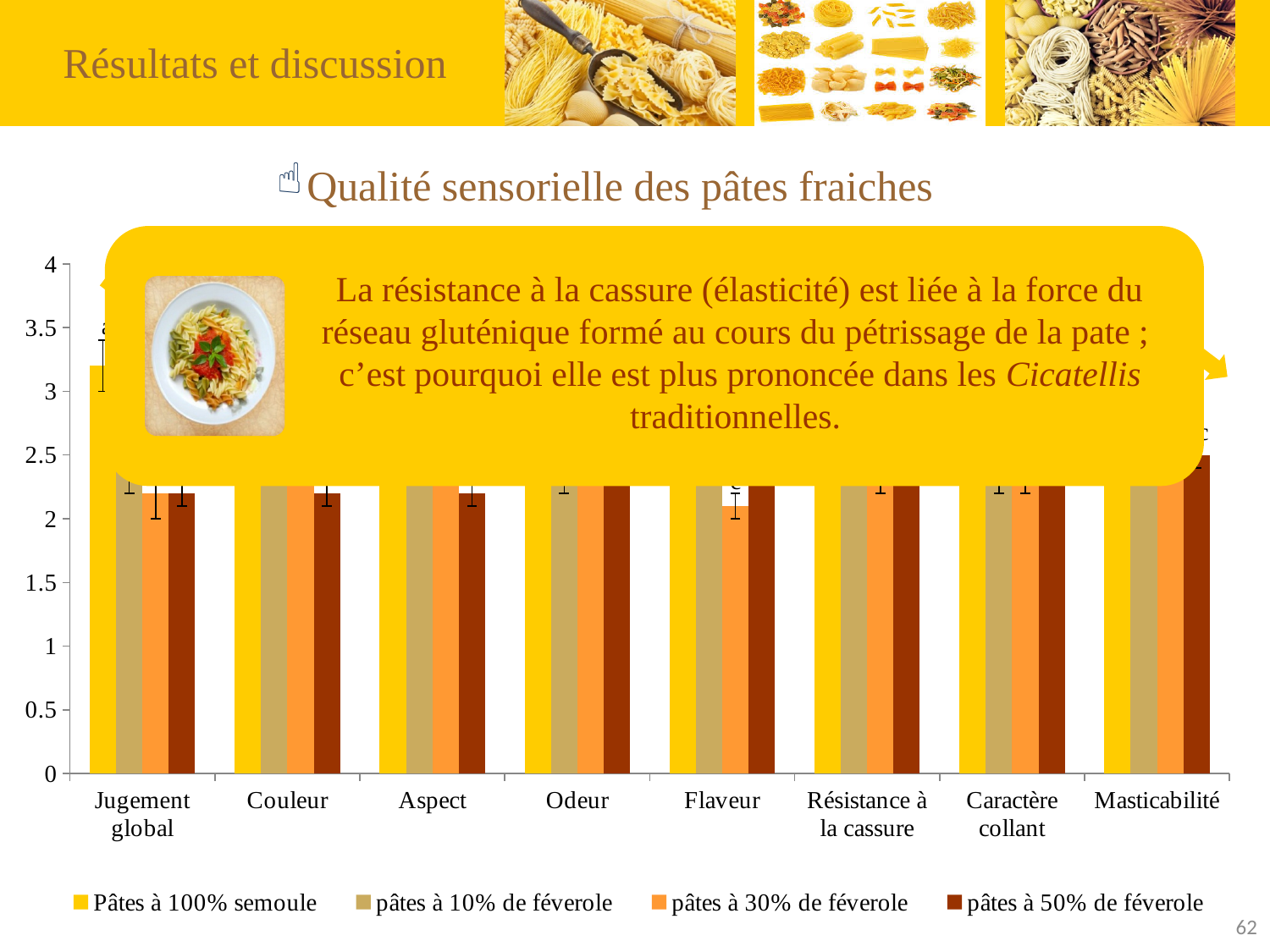
How many series does the chart legend list? 4 Which series is listed first in the chart legend? Pâtes à 100% semoule In the Jugement global category, which is larger: the value for Pâtes à 100% semoule or for pâtes à 30% de féverole? Pâtes à 100% semoule How many categories are shown along the x axis of the chart? 8 Is the value for pâtes à 50% de féverole in the Couleur category greater or less than 2.5? less Is the value for pâtes à 50% de féverole in the Masticabilité category greater or less than 2? greater What kind of chart is shown on the slide? bar chart What is the title above the chart? Qualité sensorielle des pâtes fraiches What is the highest tick value shown on the y axis of the chart? 4 Which is larger: the value for pâtes à 30% de féverole in Flaveur or the value for pâtes à 50% de féverole in Masticabilité? pâtes à 50% de féverole in Masticabilité Is the value for Pâtes à 100% semoule in the Jugement global category greater or less than 2.5? greater